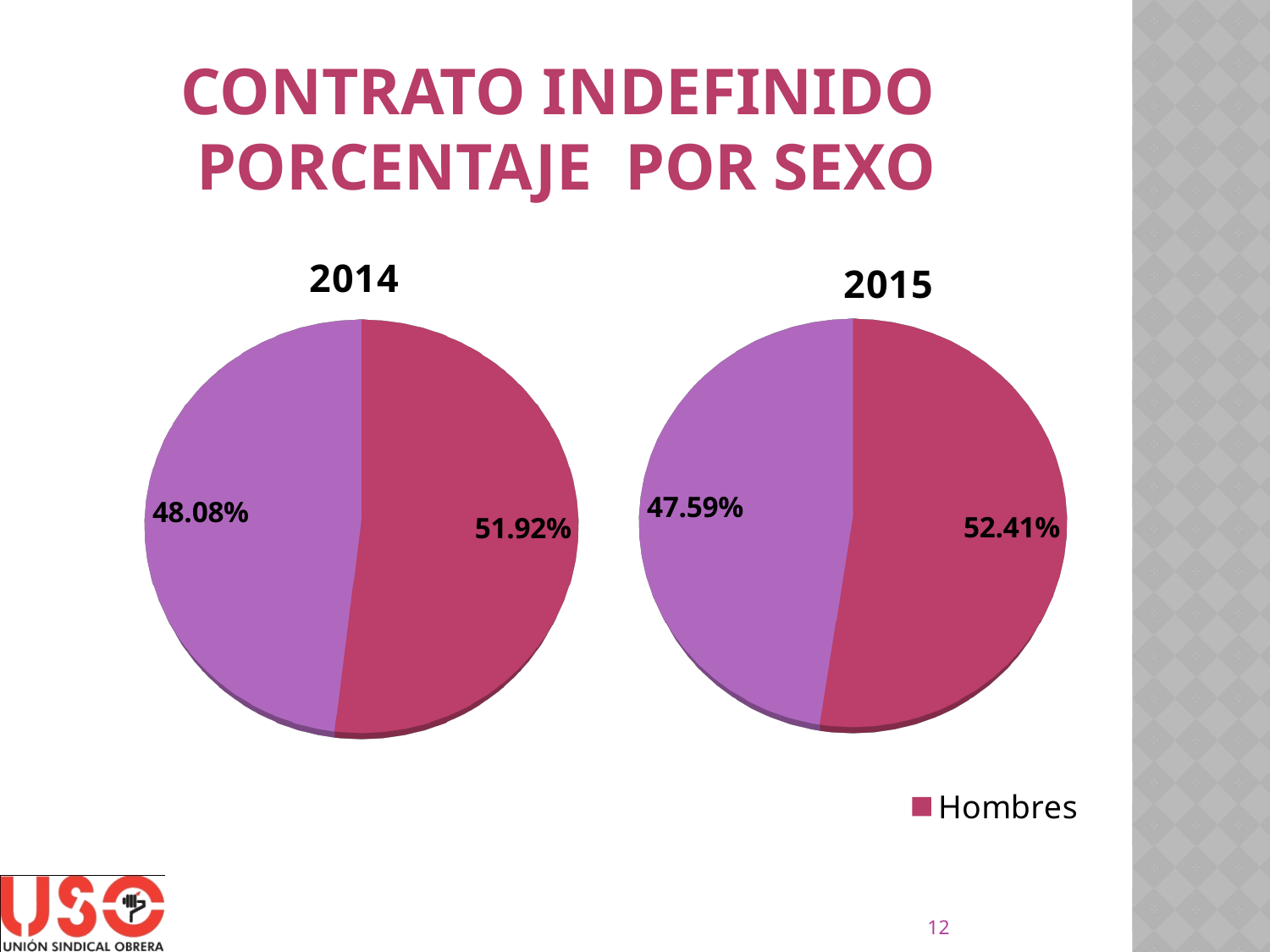
Which year's pie chart shows the larger Hombres share, 2014 or 2015? 2015 How many slices does the 2015 pie chart have? 2 In the 2014 pie chart, what share is labelled for Hombres? 51.92% In the 2015 pie chart, what is the difference between the Hombres share and the purple slice's share? 4.82% In the 2015 pie chart, what percentage is shown on the purple slice? 47.59% In the 2014 pie chart, which slice is larger, Hombres or the purple slice? Hombres In the 2014 pie chart, what is the difference between the Hombres share and the purple slice's share? 3.84% In the 2015 pie chart, what share is labelled for Hombres? 52.41% What kind of chart is used for 2014 and 2015 on this slide? Pie chart By how much did the Hombres share increase from the 2014 pie chart to the 2015 pie chart? 0.49% In the 2014 pie chart, what percentage is shown on the purple slice? 48.08% Which entry is listed in the legend on the slide? Hombres